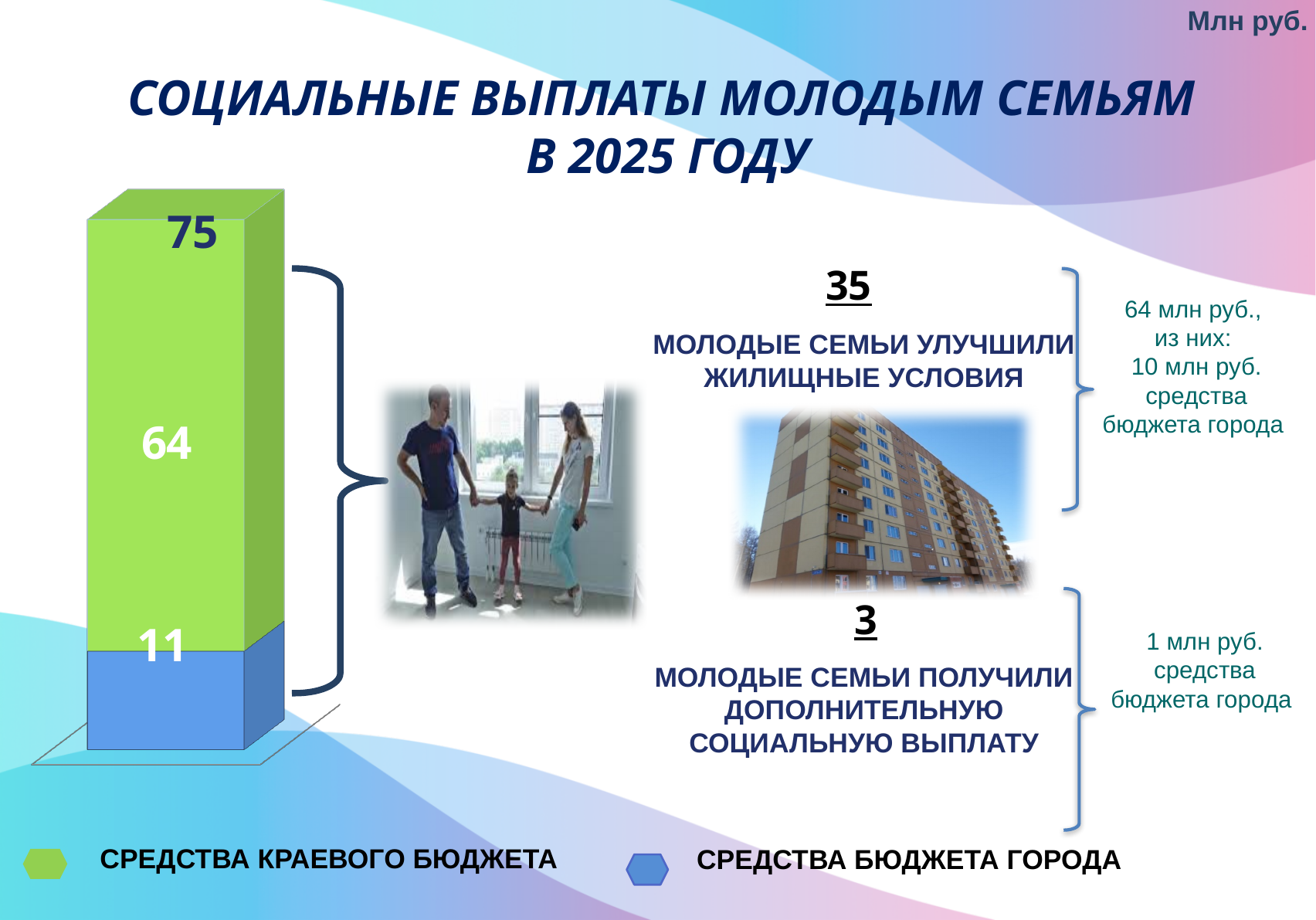
How many series does the legend list? 2 Which segment of the bar has the smallest value? City budget funds (СРЕДСТВА БЮДЖЕТА ГОРОДА) What unit of measurement is indicated for the chart values? Млн руб. Which segment of the bar is larger: regional budget funds or city budget funds? Regional budget funds (СРЕДСТВА КРАЕВОГО БЮДЖЕТА) What is the difference between the regional budget segment and the city budget segment of the bar? 53 What is the total value printed at the top of the stacked bar? 75 What value is shown for the regional budget funds (СРЕДСТВА КРАЕВОГО БЮДЖЕТА) segment of the bar? 64 Which colour represents the city budget funds (СРЕДСТВА БЮДЖЕТА ГОРОДА) in the legend? Blue What kind of chart is shown on the slide? Stacked bar chart How many bars are plotted in the chart? 1 What value is shown for the city budget funds (СРЕДСТВА БЮДЖЕТА ГОРОДА) segment of the bar? 11